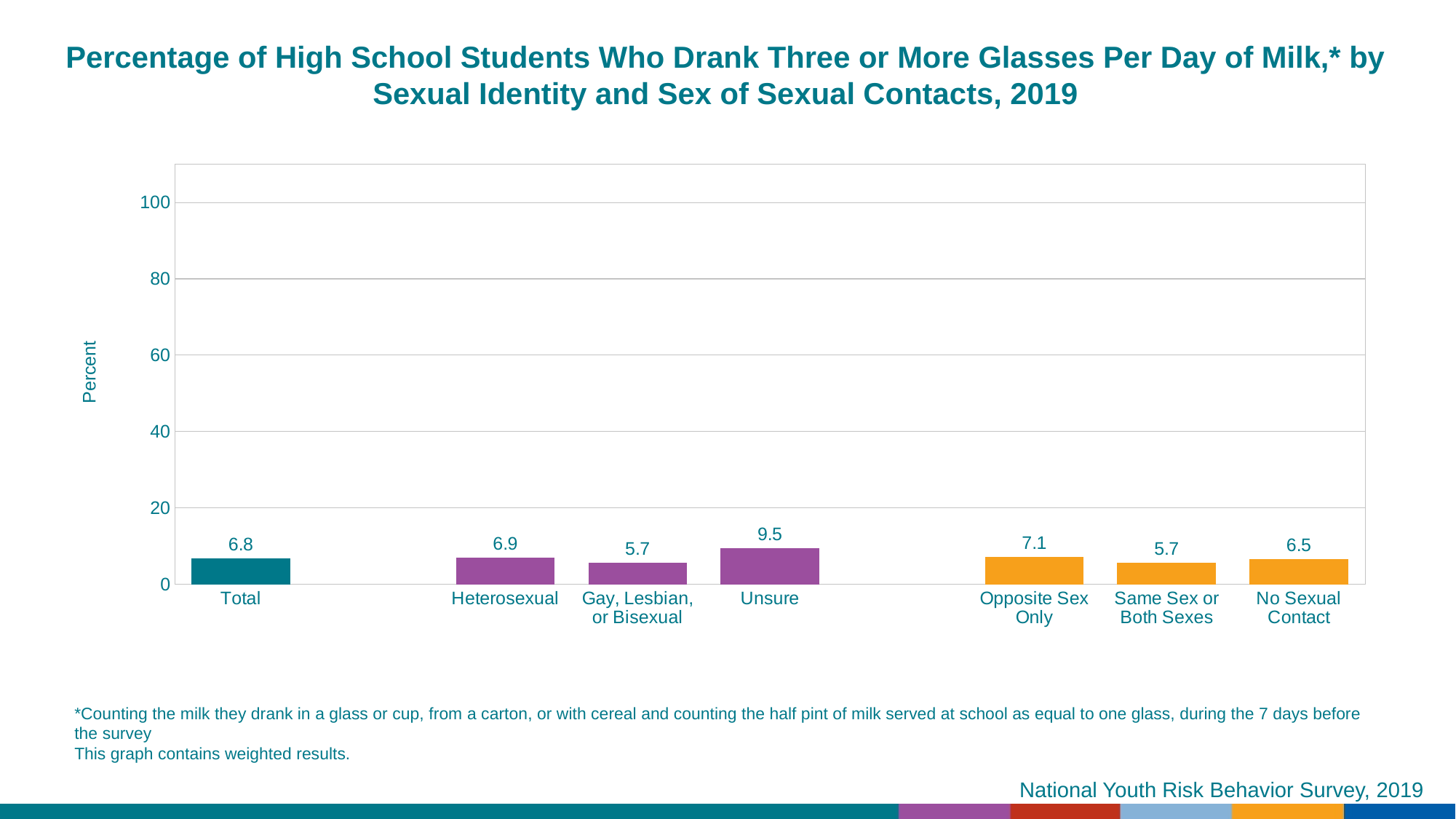
What is the difference between the values for Opposite Sex Only and No Sexual Contact? 0.6 What is the value for No Sexual Contact? 6.5 Which is larger, the value for Heterosexual or the value for Gay, Lesbian, or Bisexual? Heterosexual What is the value for Unsure? 9.5 How many categories are shown in the chart? 7 Is the value for Unsure greater or less than 20? less What is the difference between the values for Unsure and Heterosexual? 2.6 What is the label of the y axis? Percent What is the value for Opposite Sex Only? 7.1 Which category has the highest value? Unsure What is the value for Total? 6.8 What kind of chart is shown on the slide? bar chart